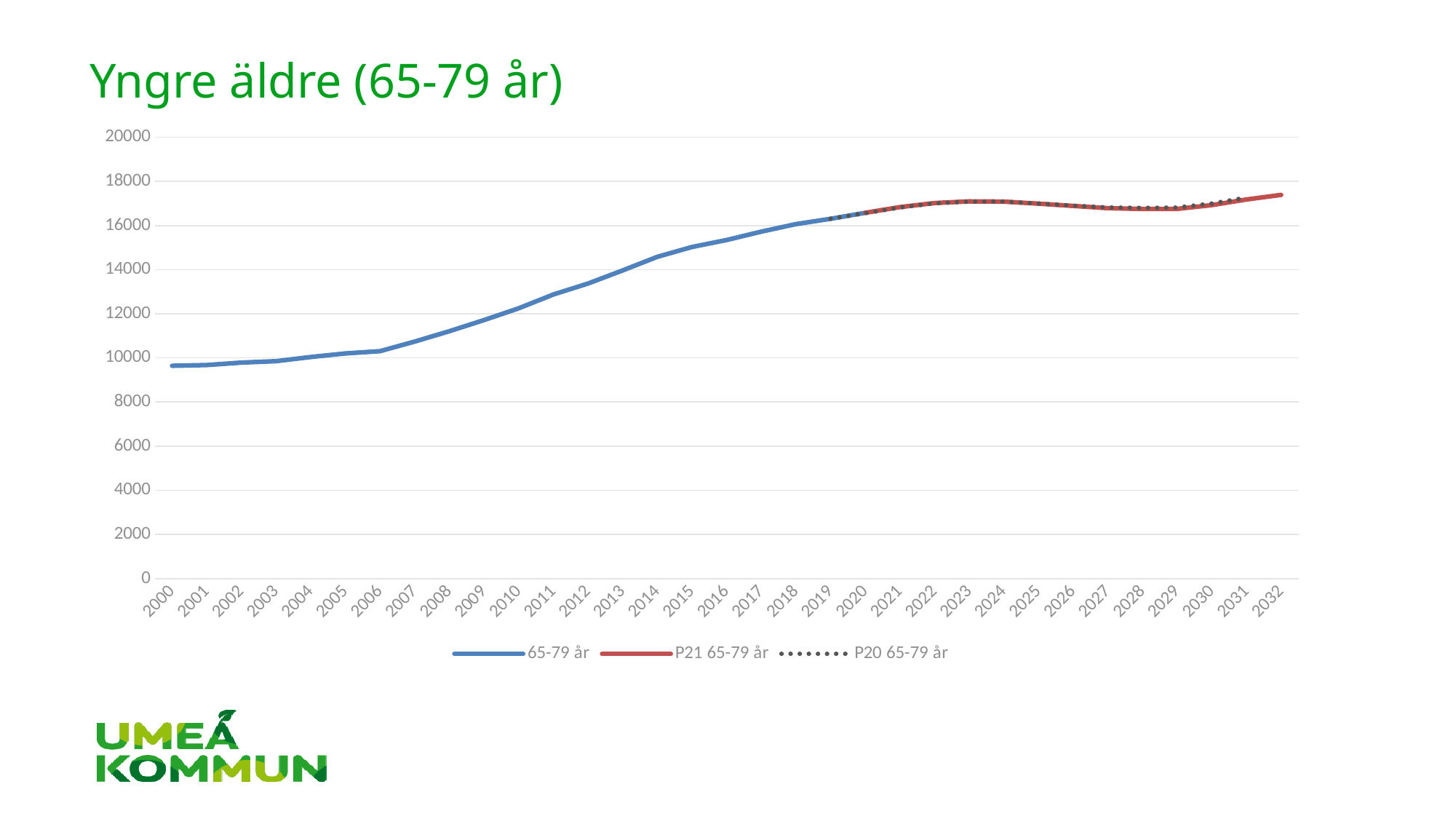
How many series does the legend list? 3 Is the value for 2023 greater or less than 16000? greater What is the title of the chart? Yngre äldre (65-79 år) Is the value for 2014 greater or less than 14000? greater How many years are shown on the x axis? 33 Which is larger, the value for 2000 or the value for 2032? 2032 What kind of chart is shown on the slide? line chart Is the value for 2000 greater or less than 10000? less Which series is drawn with a dotted line? P20 65-79 år Does the 65-79 år line generally rise or fall from 2000 to 2019? rise